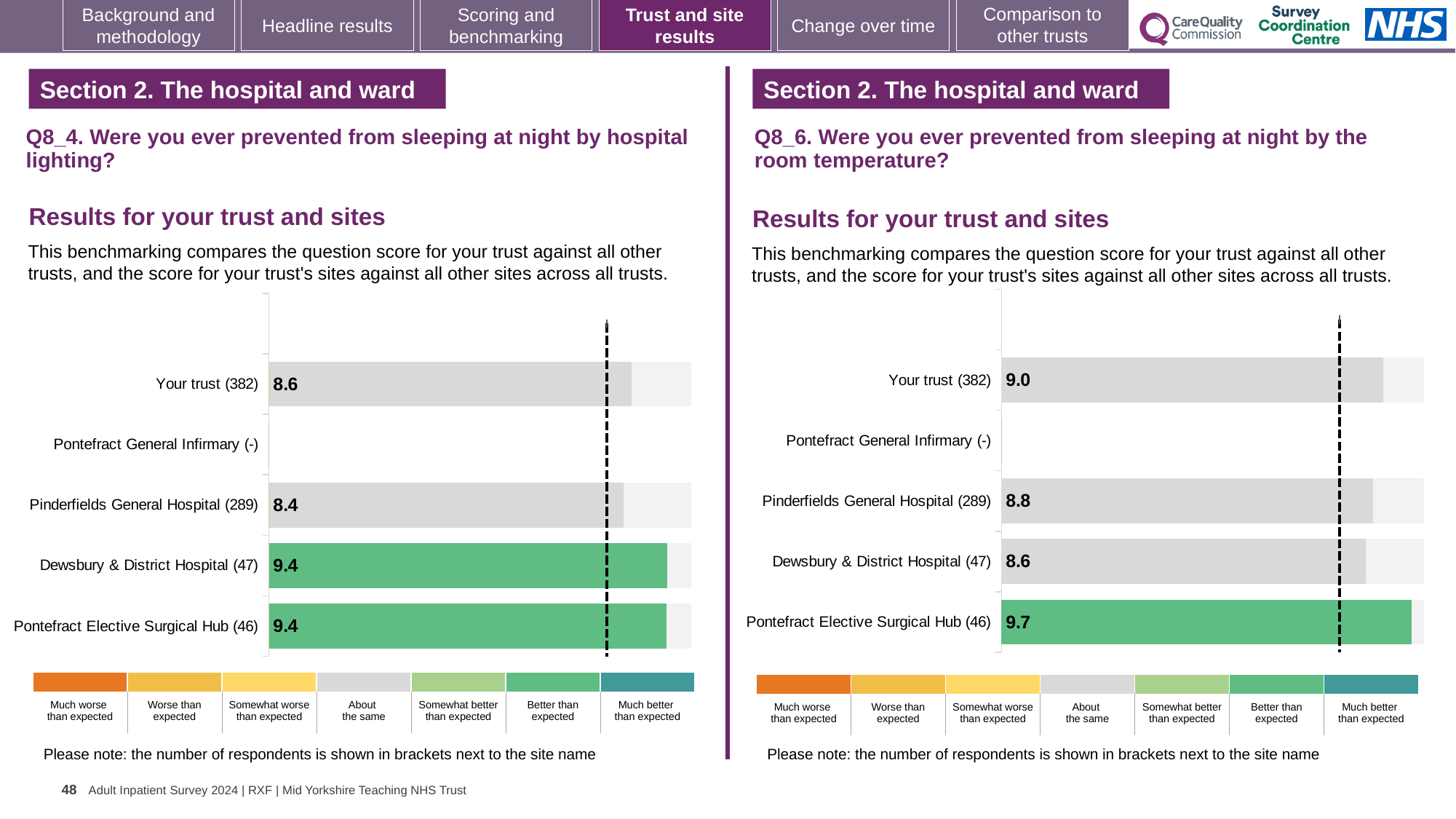
What kind of chart is used on the Q8_4 hospital lighting chart? Bar chart On the Q8_6 room temperature chart, what is the difference between the scores for Pontefract Elective Surgical Hub (46) and Pinderfields General Hospital (289)? 0.9 On the Q8_4 hospital lighting chart, which is larger: the score for Your trust (382) or for Pontefract Elective Surgical Hub (46)? Pontefract Elective Surgical Hub (46) On the Q8_4 hospital lighting chart, what is the score for Your trust (382)? 8.6 On the Q8_6 room temperature chart, which site has the highest score? Pontefract Elective Surgical Hub (46) On the Q8_4 hospital lighting chart, which site has the lowest score? Pinderfields General Hospital (289) On the Q8_4 hospital lighting chart, what is the score for Pinderfields General Hospital (289)? 8.4 On the Q8_6 room temperature chart, what is the score for Your trust (382)? 9.0 On the Q8_6 room temperature chart, which site has the lowest score among those with a bar? Dewsbury & District Hospital (47) How many site/trust labels are listed on the Q8_6 room temperature chart? 5 On the Q8_6 room temperature chart, what is the score for Dewsbury & District Hospital (47)? 8.6 On the Q8_4 hospital lighting chart, what is the difference between the scores for Dewsbury & District Hospital (47) and Pinderfields General Hospital (289)? 1.0